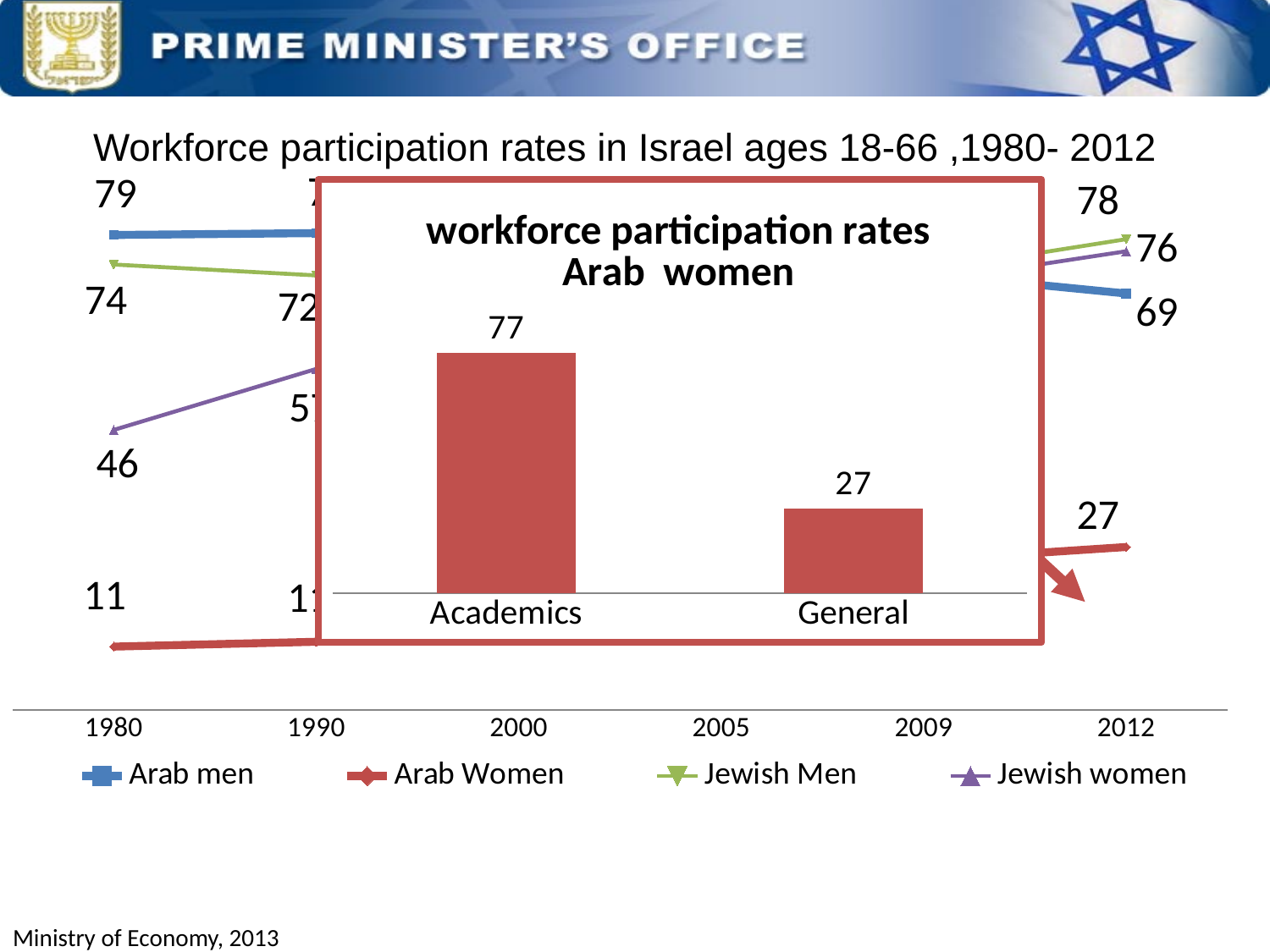
In the 'workforce participation rates Arab women' bar chart, what is the difference between the Academics and General values? 50 How many categories are shown in the 'workforce participation rates Arab women' bar chart? 2 In the 'workforce participation rates Arab women' bar chart, what is the value for General? 27 In the 'Workforce participation rates in Israel ages 18-66, 1980-2012' line chart, what is the value for Jewish Men in 2012? 78 In the 'workforce participation rates Arab women' bar chart, which category has the higher value? Academics What kind of chart is the 'workforce participation rates Arab women' chart? Bar chart In the 'Workforce participation rates in Israel ages 18-66, 1980-2012' line chart, what is the value for Arab Women in 2012? 27 How many series does the legend of the 'Workforce participation rates in Israel ages 18-66, 1980-2012' line chart list? 4 In the 'Workforce participation rates in Israel ages 18-66, 1980-2012' line chart, what is the value for Arab men in 1980? 79 In the 'Workforce participation rates in Israel ages 18-66, 1980-2012' line chart, what is the difference between the Arab men value in 1980 and in 2012? 10 In the 'workforce participation rates Arab women' bar chart, what is the value for Academics? 77 In the 'Workforce participation rates in Israel ages 18-66, 1980-2012' line chart, does the Jewish women series rise or fall from 1980 to 2012? Rise